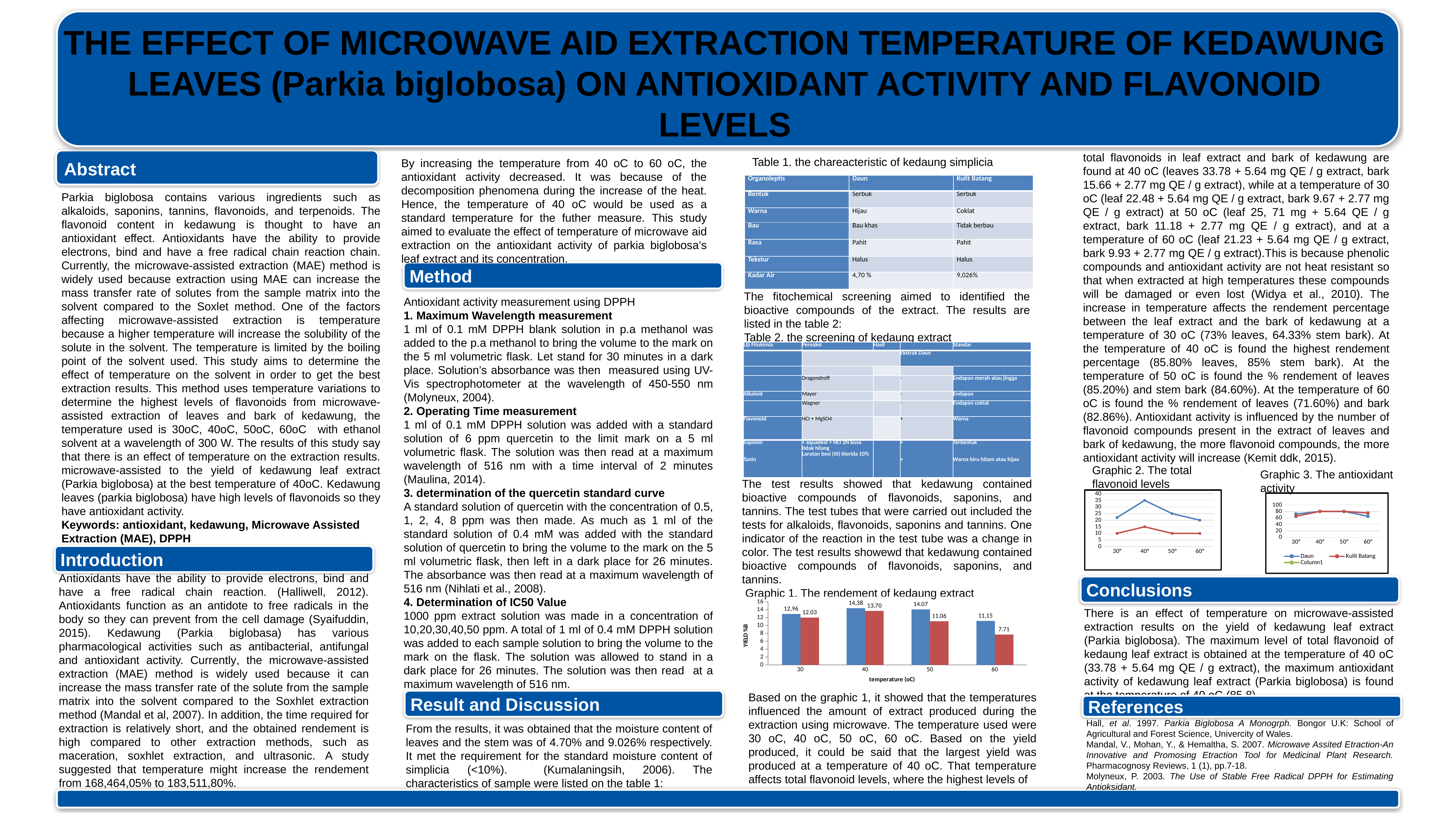
In Graphic 1, at which temperature is the red bar lowest? 60 In Graphic 1, at which temperature is the blue bar highest? 40 In Graphic 1, what is the difference between the blue bar (14.07) and the red bar (11.06) at 50 oC? 3.01 In Graphic 2, is the value of the blue line at 40° greater or less than 30? greater In Graphic 1, which bar is larger at 30 oC, the blue bar or the red bar? the blue bar In Graphic 3, the antioxidant activity, is the value of the Daun line at 40° greater or less than 60? greater In Graphic 2, does the blue line rise or fall from 40° to 60°? fall In Graphic 1, how many temperature categories are shown on the x axis? 4 What kind of chart is Graphic 1, the rendement of kedaung extract? bar chart In Graphic 1, what is the value of the red bar at 60 oC? 7.71 In Graphic 1, what is the value of the blue bar at 40 oC? 14,38 What kind of chart is Graphic 2, the total flavonoid levels? line chart